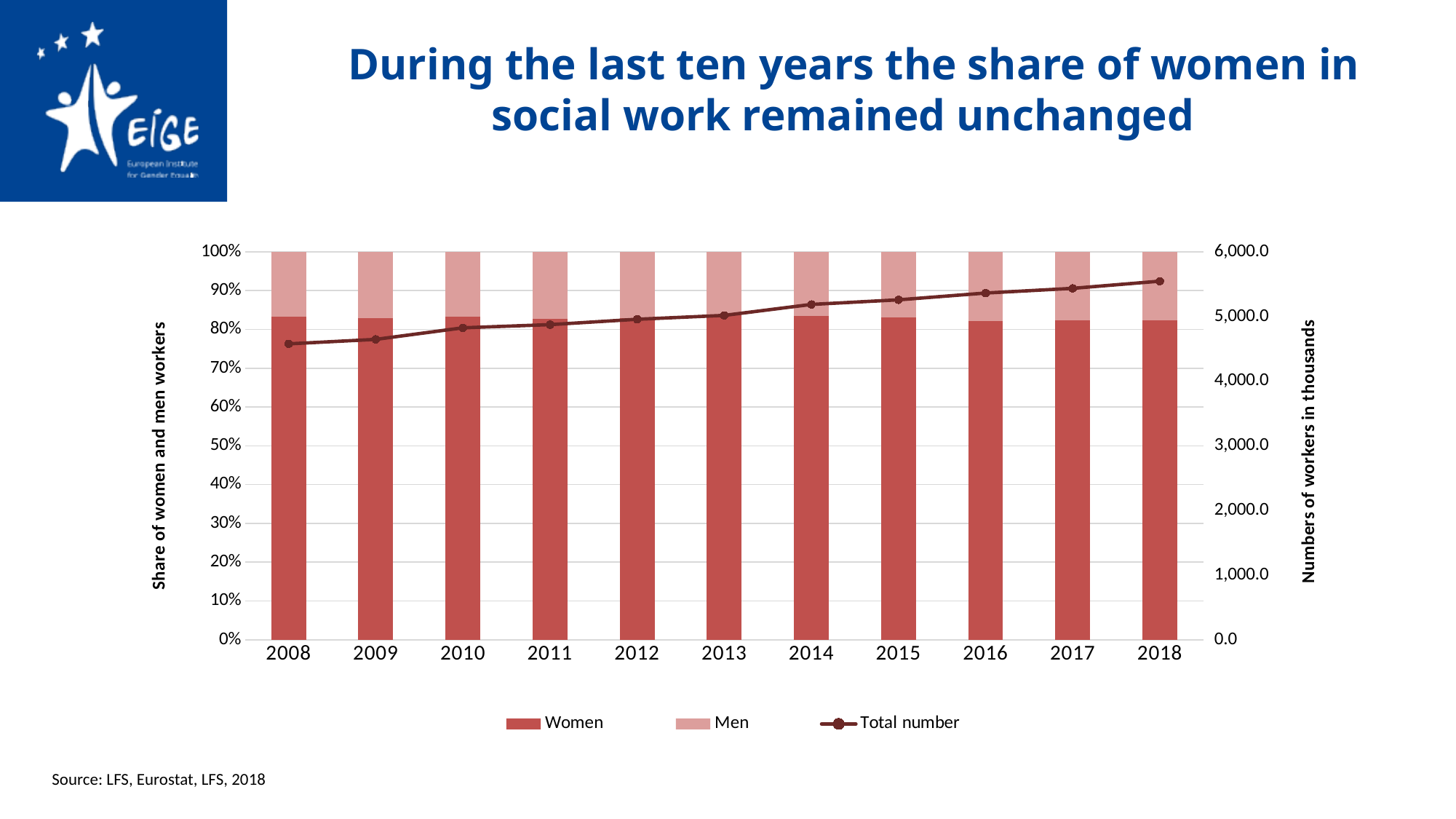
In which year is the Total number lowest? 2008 Does the Total number line rise or fall from 2008 to 2018? Rises How many series does the chart's legend list? 3 What is the title of the right-hand vertical axis? Numbers of workers in thousands Which is larger, the Total number in 2018 or the Total number in 2008? 2018 What are the three series listed in the chart's legend? Women, Men, Total number Is the Total number for 2018 greater or less than 5,000.0? greater What kind of chart is shown on the slide? A stacked bar chart combined with a line How many years are shown along the x axis of the chart? 11 In which year is the Total number highest? 2018 Is the share of Women in 2008 greater or less than 70%? greater Is the Total number for 2008 greater or less than 5,000.0? less